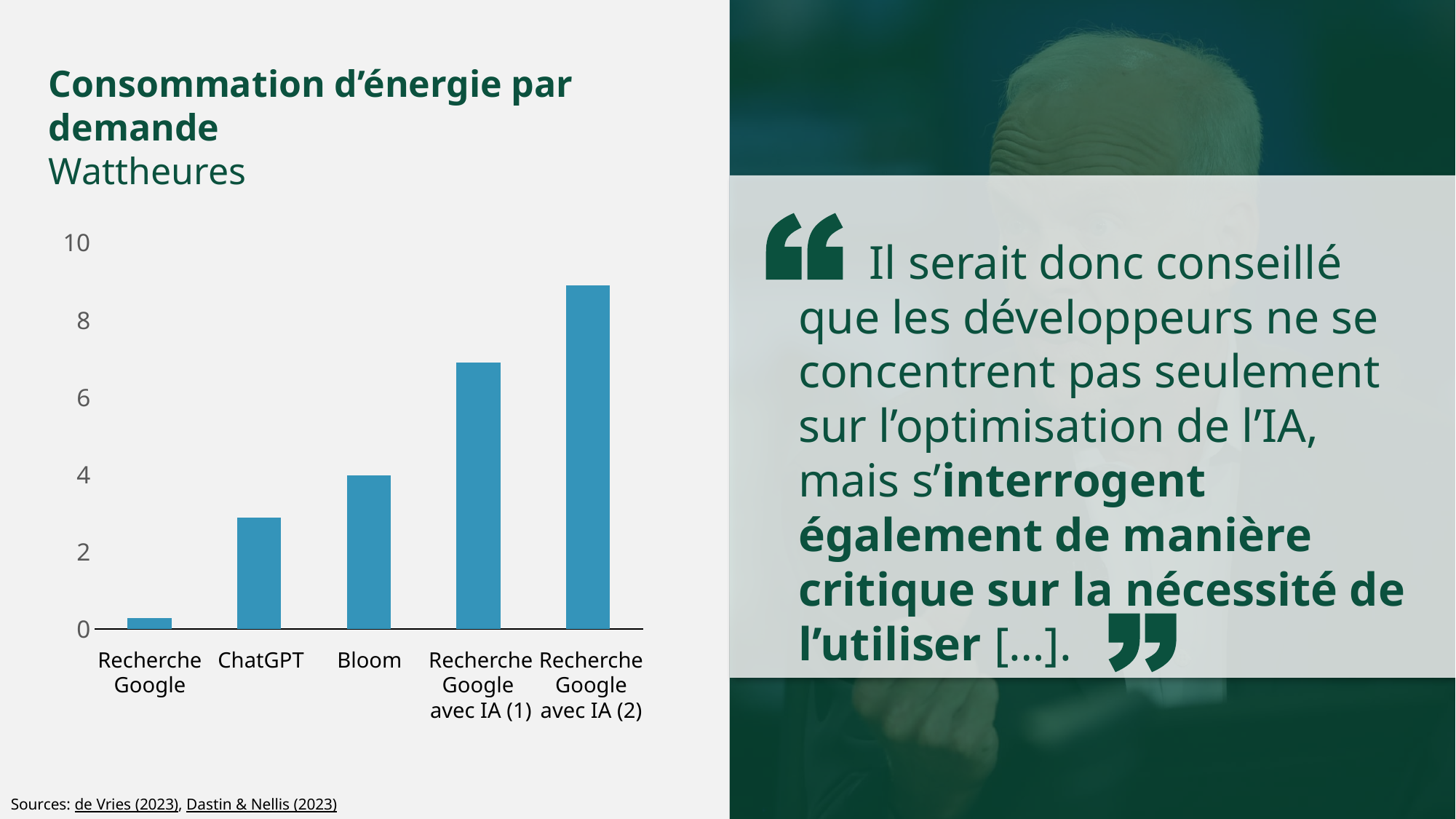
Is the value for Recherche Google greater or less than 2? less In what unit are the values of the chart expressed? Wattheures How many categories are shown on the x axis of the chart? 5 Do the values rise or fall from left to right along the x axis? rise Which category has the highest energy consumption per request? Recherche Google avec IA (2) Is the value for ChatGPT greater or less than 4? less Is the value for Recherche Google avec IA (1) greater or less than 6? greater Which is larger, the value for ChatGPT or the value for Bloom? Bloom Which category has the lowest energy consumption per request? Recherche Google Which is larger, the value for Recherche Google avec IA (1) or the value for Recherche Google avec IA (2)? Recherche Google avec IA (2) What kind of chart is shown on the slide? bar chart